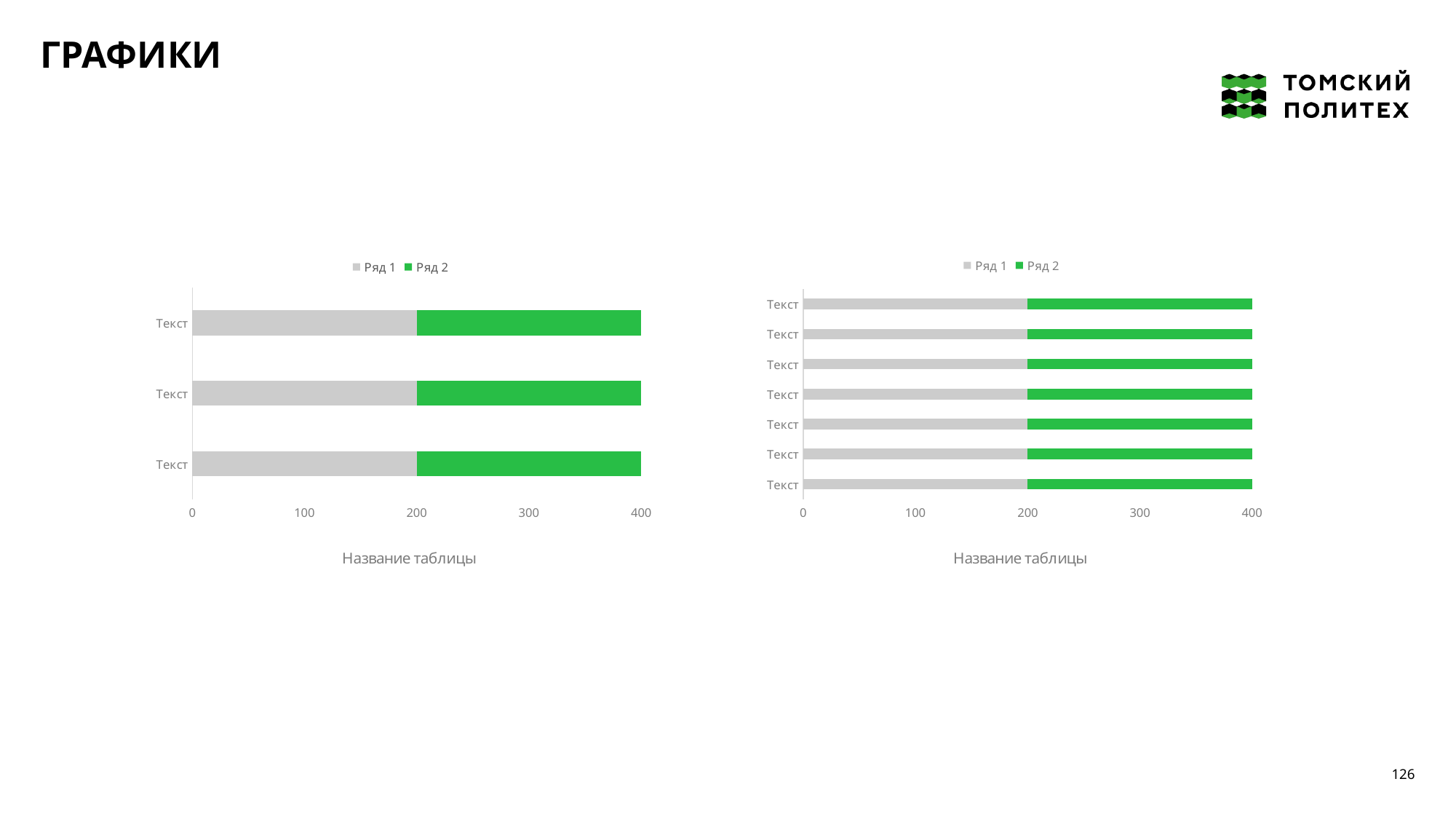
In the right chart, is the total of the top bar greater or less than 300? greater How many bars (categories) does the left chart show? 3 In the left chart, what is the value of Ряд 1 for the top bar? 200 In the left chart, what is the difference between Ряд 1 and Ряд 2 for the middle bar? 0 In the right chart, what is the value of Ряд 2 for the bottom bar? 200 In the right chart, what is the total of the bottom stacked bar? 400 In the left chart, what is the total of the top stacked bar? 400 How many bars (categories) does the right chart show? 7 What kind of chart is the left chart on the slide? stacked bar chart What are the two legend entries of the right chart? Ряд 1, Ряд 2 How many series does the legend of the left chart list? 2 What colour represents Ряд 2 in the left chart? green